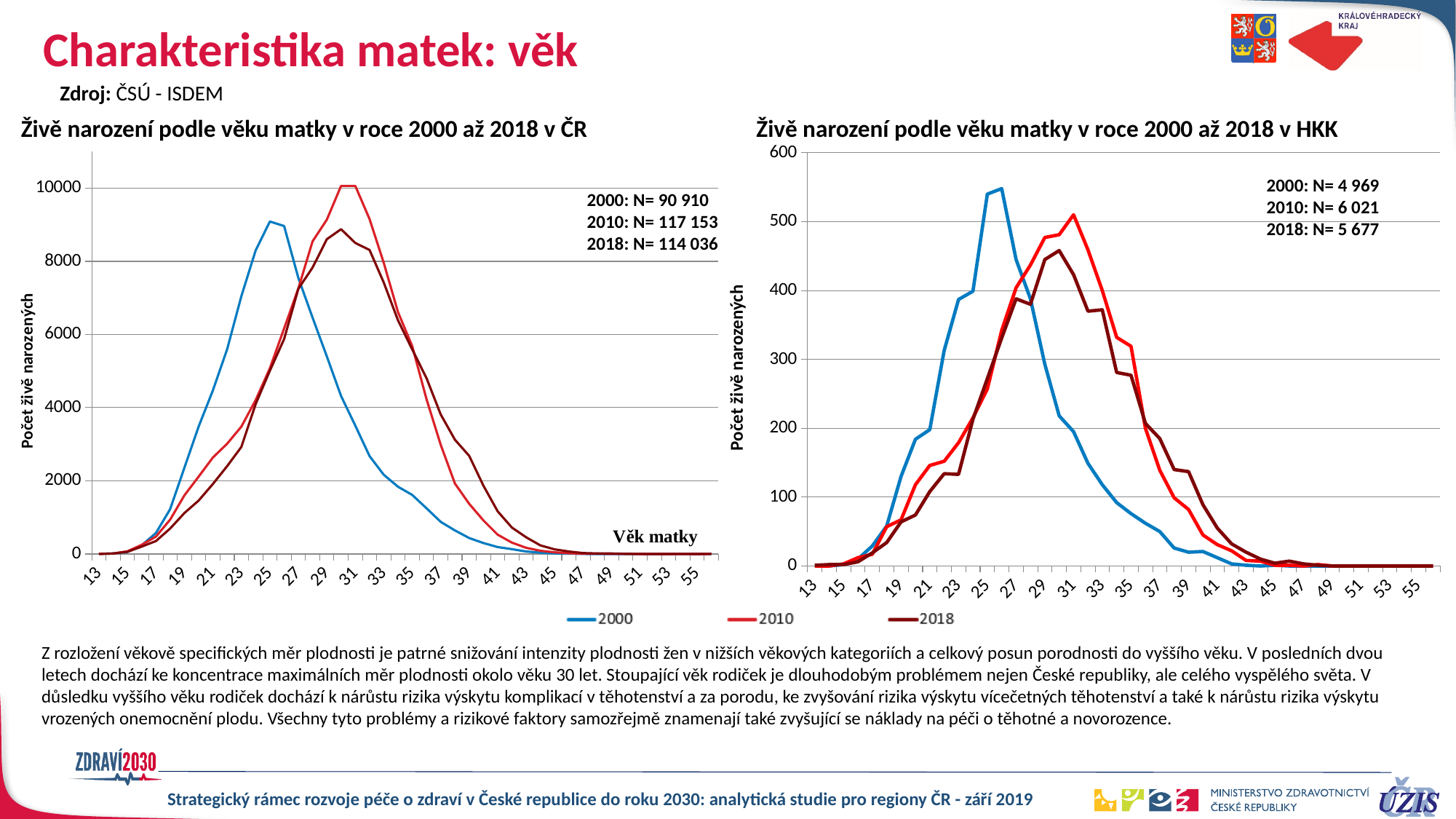
In the right chart (HKK), is the peak value of the 2018 series greater or less than 500? less In the left chart (ČR), at mother's age 25, which series has the larger value, 2000 or 2010? 2000 In the right chart (HKK), which series reaches the highest peak? 2000 What type of chart is the left chart titled 'Živě narození podle věku matky v roce 2000 až 2018 v ČR'? Line chart In the left chart (ČR), is the peak value of the 2018 series greater or less than 8000? greater In the right chart (HKK), what is the N value printed for 2018? 5 677 How many series does the legend list for the charts on the slide? 3 In the left chart (ČR), what is the N value printed for 2010? 117 153 In the left chart (ČR), is the peak value of the 2000 series greater or less than 8000? greater In the left chart (ČR), does the 2000 series rise or fall between ages 25 and 45? Fall In the left chart (ČR), which series reaches the highest peak? 2010